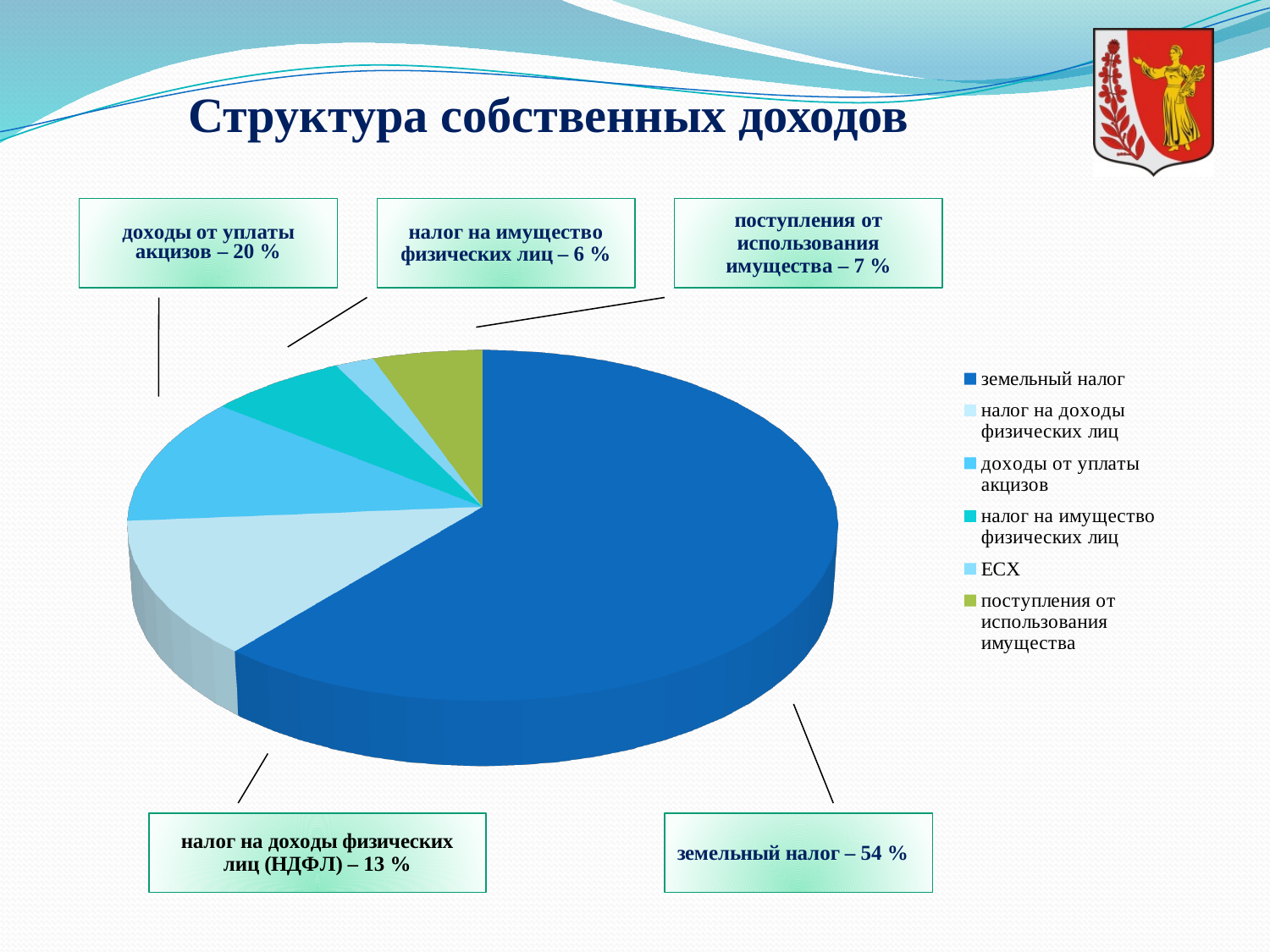
How many percentage points larger is земельный налог than налог на доходы физических лиц (НДФЛ)? 41 What share is shown for налог на доходы физических лиц (НДФЛ)? 13 % Which is larger: поступления от использования имущества or налог на имущество физических лиц? поступления от использования имущества Which category has the largest share of own revenues? земельный налог What share of own revenues does земельный налог account for? 54 % What kind of chart is shown on the slide? pie chart What share is shown for доходы от уплаты акцизов? 20 % What share is shown for налог на имущество физических лиц? 6 % What is the title of the slide containing the chart? Структура собственных доходов How many categories does the legend list? 6 What share is shown for поступления от использования имущества? 7 % What is the difference in percentage points between доходы от уплаты акцизов and налог на имущество физических лиц? 14